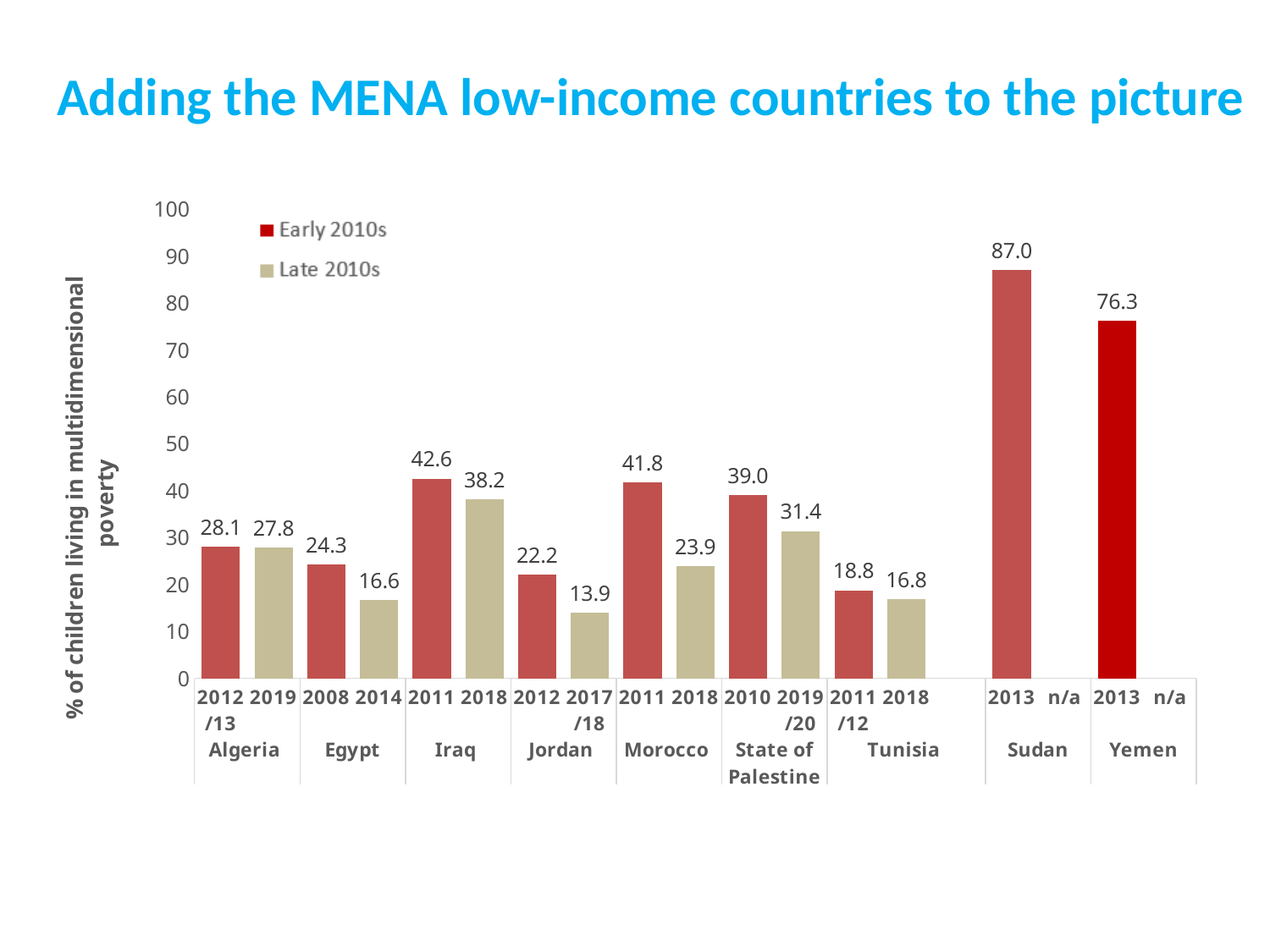
What is the Early 2010s value for Iraq? 42.6 What is the Late 2010s value for Yemen? n/a What kind of chart is shown on the slide? Bar chart How many countries are shown on the x axis? 9 Which country has the highest value on the chart? Sudan What is the title of the slide? Adding the MENA low-income countries to the picture What is the value shown for Sudan in 2013? 87.0 What is the difference between the Early 2010s and Late 2010s values for Morocco? 17.9 What is the Late 2010s value for Egypt? 16.6 Which is larger, the Early 2010s value for Tunisia or the Early 2010s value for Jordan? Jordan How many series does the legend list? 2 Which country has the lowest Late 2010s value? Jordan